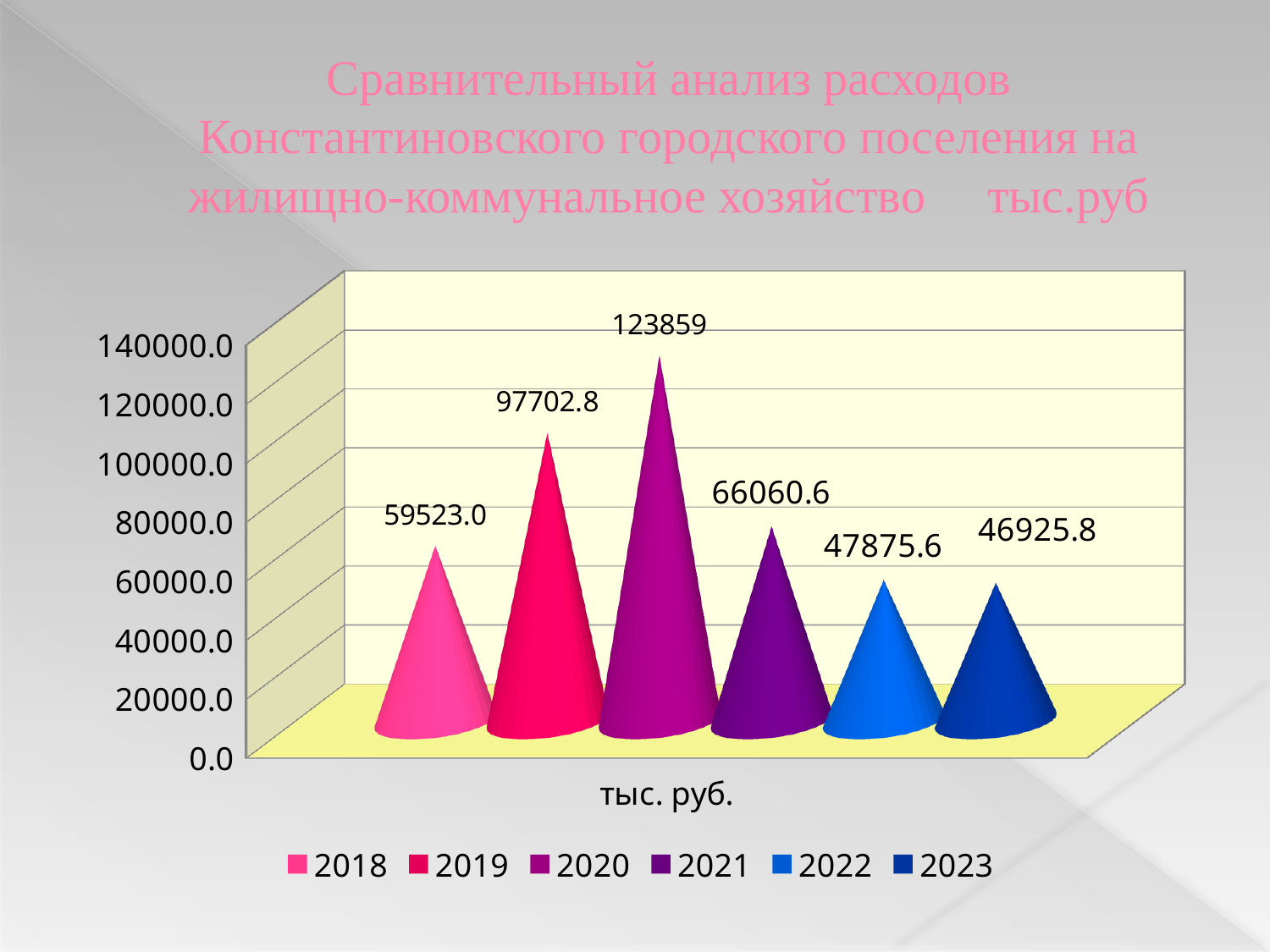
What is the difference between the values for 2021 and 2018? 6537.6 What is the value for 2023? 46925.8 Which year has the lowest value? 2023 Which year has the highest value? 2020 Is the value for 2019 greater or less than 100000.0? less How many series does the legend list? 6 Which is larger, the value for 2022 or the value for 2023? 2022 What is the value for 2018? 59523.0 What is the value for 2020? 123859 What is the difference between the values for 2020 and 2019? 26156.2 What is the label shown below the chart's horizontal axis? тыс. руб. What kind of chart is shown on the slide? bar chart